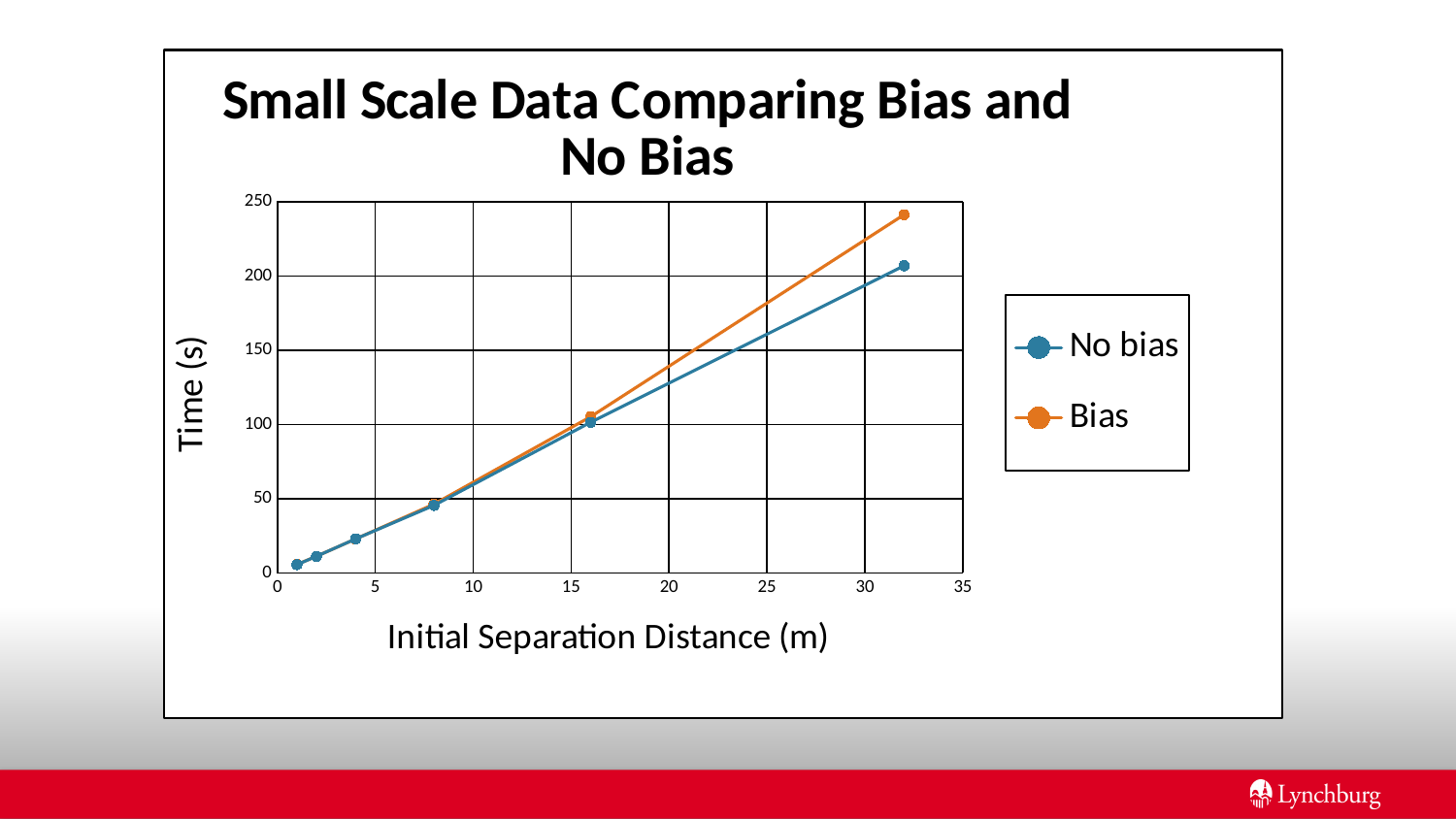
At an initial separation distance of 32 m, which series has the larger time, Bias or No bias? Bias How many data points are plotted for the Bias series? 6 Is the time for the No bias series at 32 m greater or less than 250? less Is the time for the Bias series at 32 m greater or less than 200? greater How many series does the legend list? 2 Does the time for the No bias series rise or fall as the initial separation distance increases? rise What kind of chart is shown on the slide? line chart What is the title of the chart? Small Scale Data Comparing Bias and No Bias What are the names of the two series in the legend? No bias and Bias Which series reaches the highest time value on the chart? Bias Is the time for the Bias series at 16 m greater or less than 50? greater